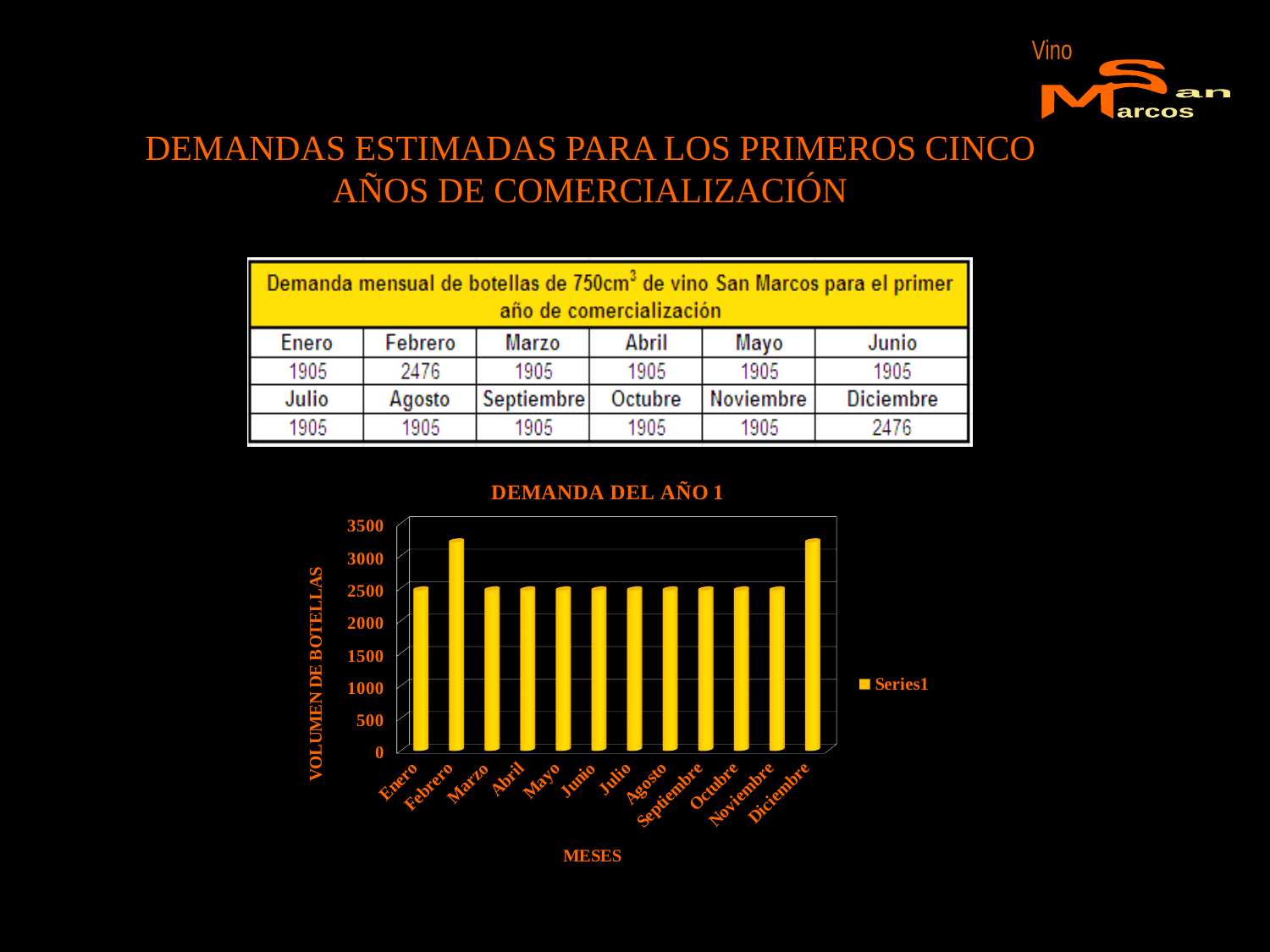
Is the value for Marzo in the DEMANDA DEL AÑO 1 chart greater or less than 3000? less Is the value for Febrero in the DEMANDA DEL AÑO 1 chart greater or less than 3000? greater In the DEMANDA DEL AÑO 1 chart, which is larger, the bar for Noviembre or the bar for Diciembre? Diciembre What kind of chart is shown under the title DEMANDA DEL AÑO 1? bar chart What is the title of the chart on the slide? DEMANDA DEL AÑO 1 Is the value for Julio in the DEMANDA DEL AÑO 1 chart greater or less than 2000? greater What is the label of the vertical axis of the DEMANDA DEL AÑO 1 chart? VOLUMEN DE BOTELLAS In the DEMANDA DEL AÑO 1 chart, which is larger, the bar for Febrero or the bar for Marzo? Febrero How many series does the legend of the DEMANDA DEL AÑO 1 chart list? 1 How many months (categories) are plotted on the x axis of the DEMANDA DEL AÑO 1 chart? 12